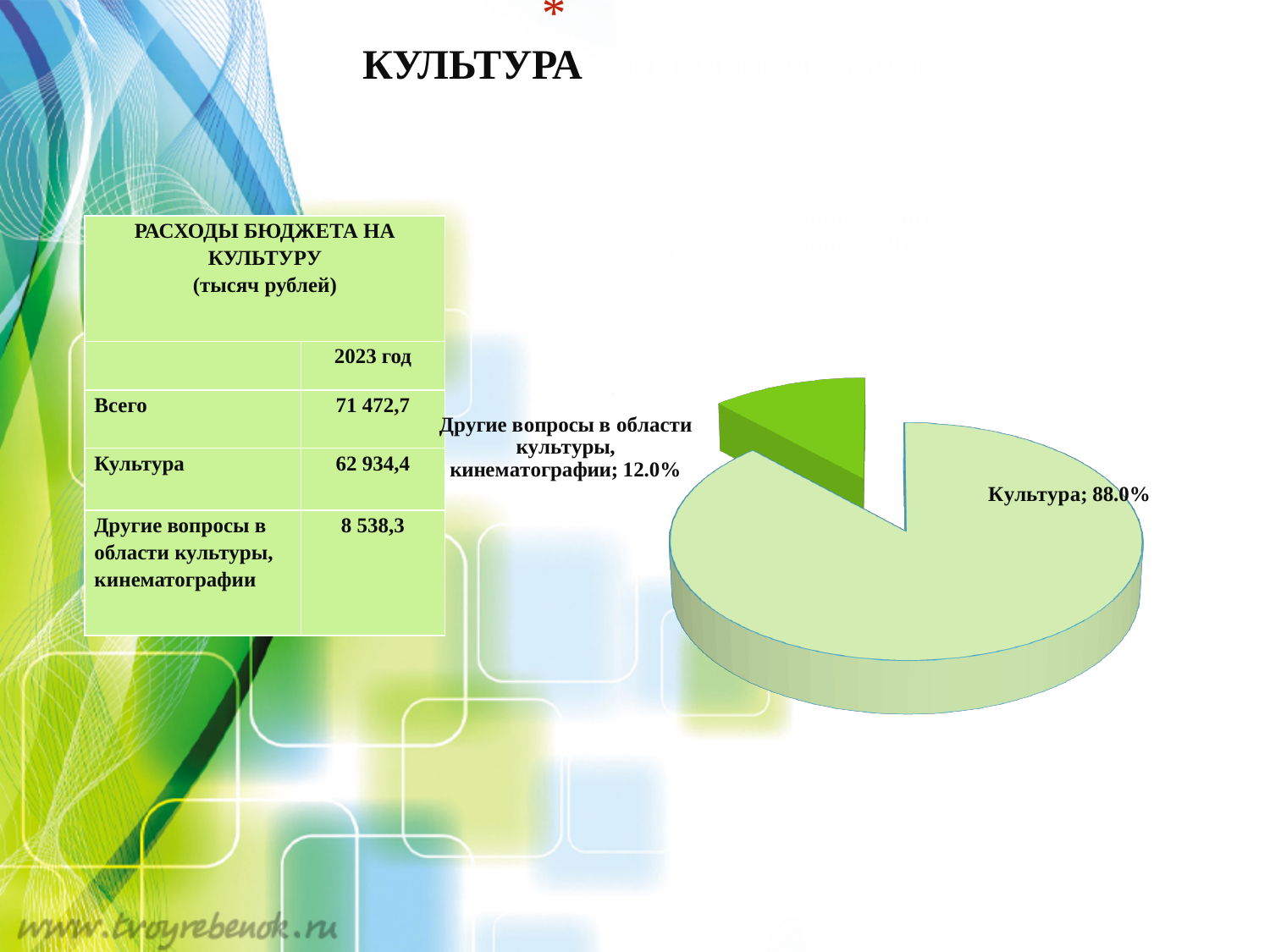
What share of the pie chart does the "Другие вопросы в области культуры, кинематографии" slice represent? 12.0% Which slice of the pie chart is the largest? Культура Which is larger in the pie chart: the "Культура" slice or the "Другие вопросы в области культуры, кинематографии" slice? Культура Which slice of the pie chart is pulled out (exploded) from the rest of the pie? Другие вопросы в области культуры, кинематографии What kind of chart is shown on the slide? Pie chart Which slice of the pie chart is the smallest? Другие вопросы в области культуры, кинематографии What is the difference in percentage points between the "Культура" slice and the "Другие вопросы в области культуры, кинематографии" slice? 76.0 percentage points How many slices does the pie chart have? 2 What colour is the "Культура" slice in the pie chart? Light green What share of the pie chart does the "Культура" slice represent? 88.0% Is the share of the "Культура" slice greater or less than 50%? greater